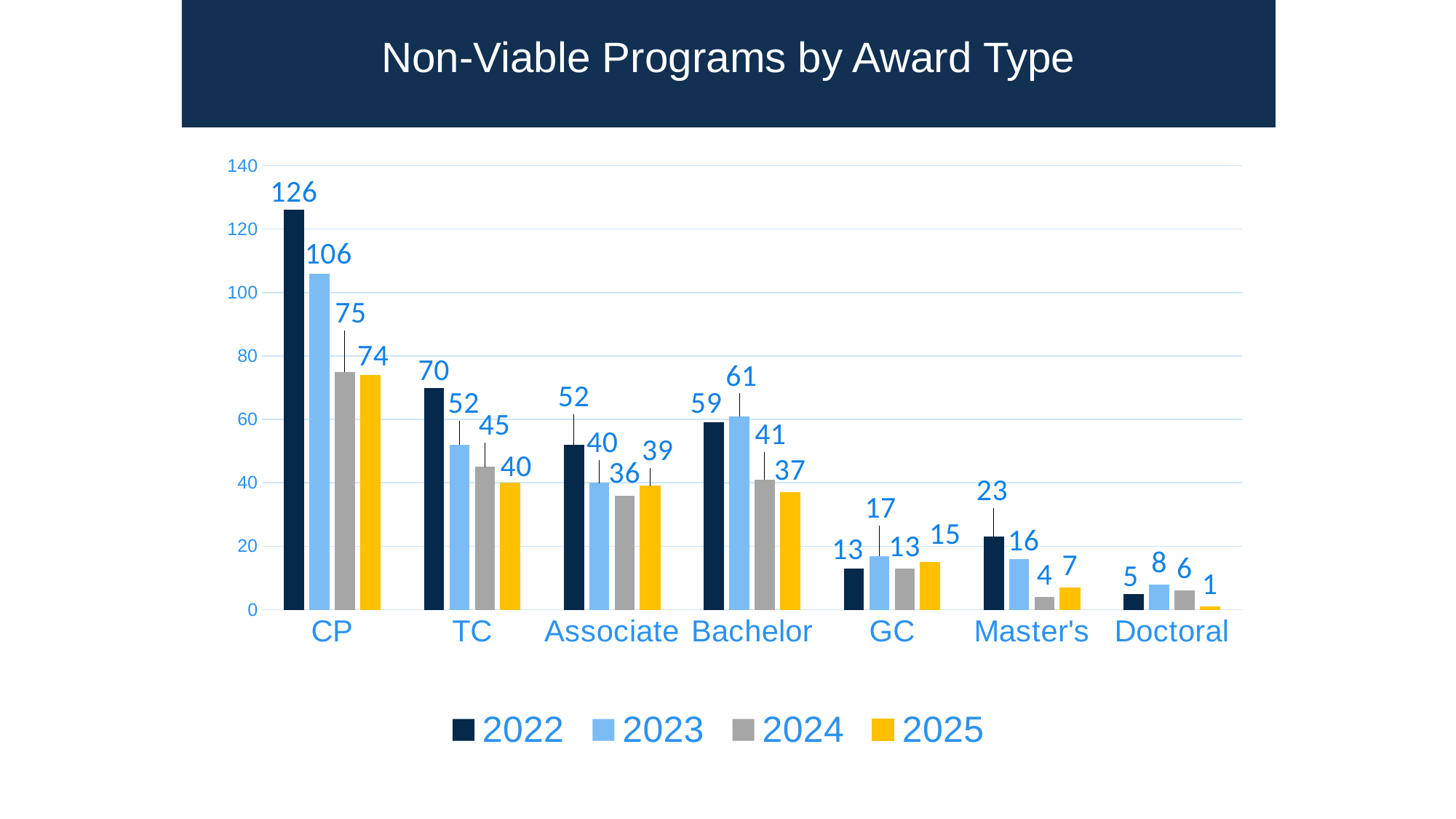
Which award type has the lowest value in 2022? Doctoral What is the value for Master's in 2024? 4 Which award type has the highest value in 2025? CP How many award types are shown on the x axis? 7 What is the value for Bachelor in 2023? 61 How many series does the legend list? 4 Which is larger for Associate: the 2024 value or the 2025 value? 2025 What is the title of the chart? Non-Viable Programs by Award Type What kind of chart is this? bar chart What is the difference between the 2022 and 2023 values for TC? 18 What is the value for CP in 2022? 126